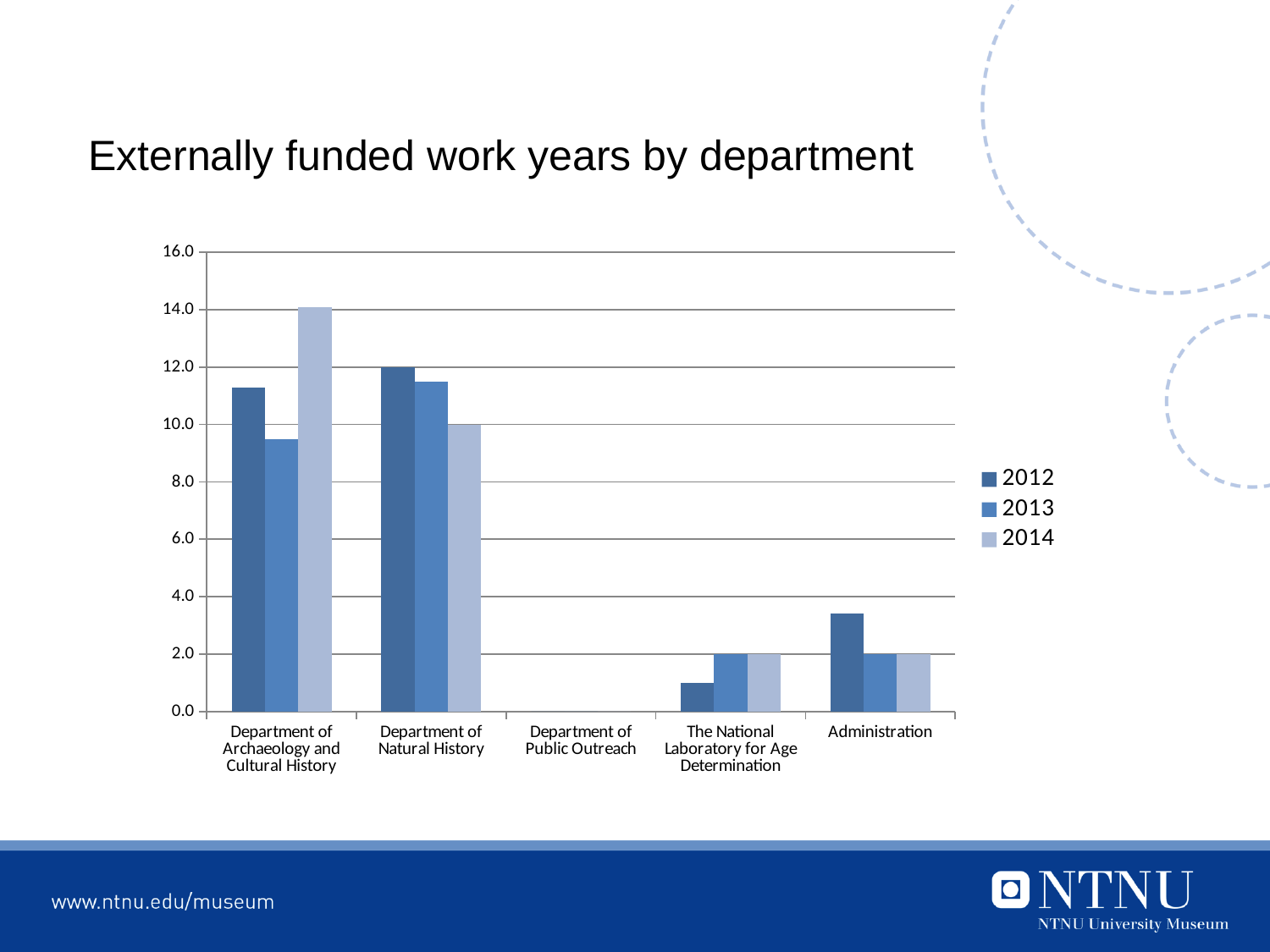
What is the value for the Department of Natural History in 2012? 12.0 For the Department of Archaeology and Cultural History, which is larger, the 2012 value or the 2013 value? 2012 Which department has the tallest bar in the chart? Department of Archaeology and Cultural History Is the 2012 value for Administration greater or less than 4.0? less Is the 2014 value for the Department of Archaeology and Cultural History greater or less than 12.0? greater Which years are listed in the legend? 2012, 2013, 2014 How many departments are shown on the x axis? 5 How many series does the legend list? 3 What kind of chart is shown on the slide? bar chart What is the value for the Department of Natural History in 2014? 10.0 What is the value for Administration in 2013? 2.0 Which department shows no visible bars for any year? Department of Public Outreach